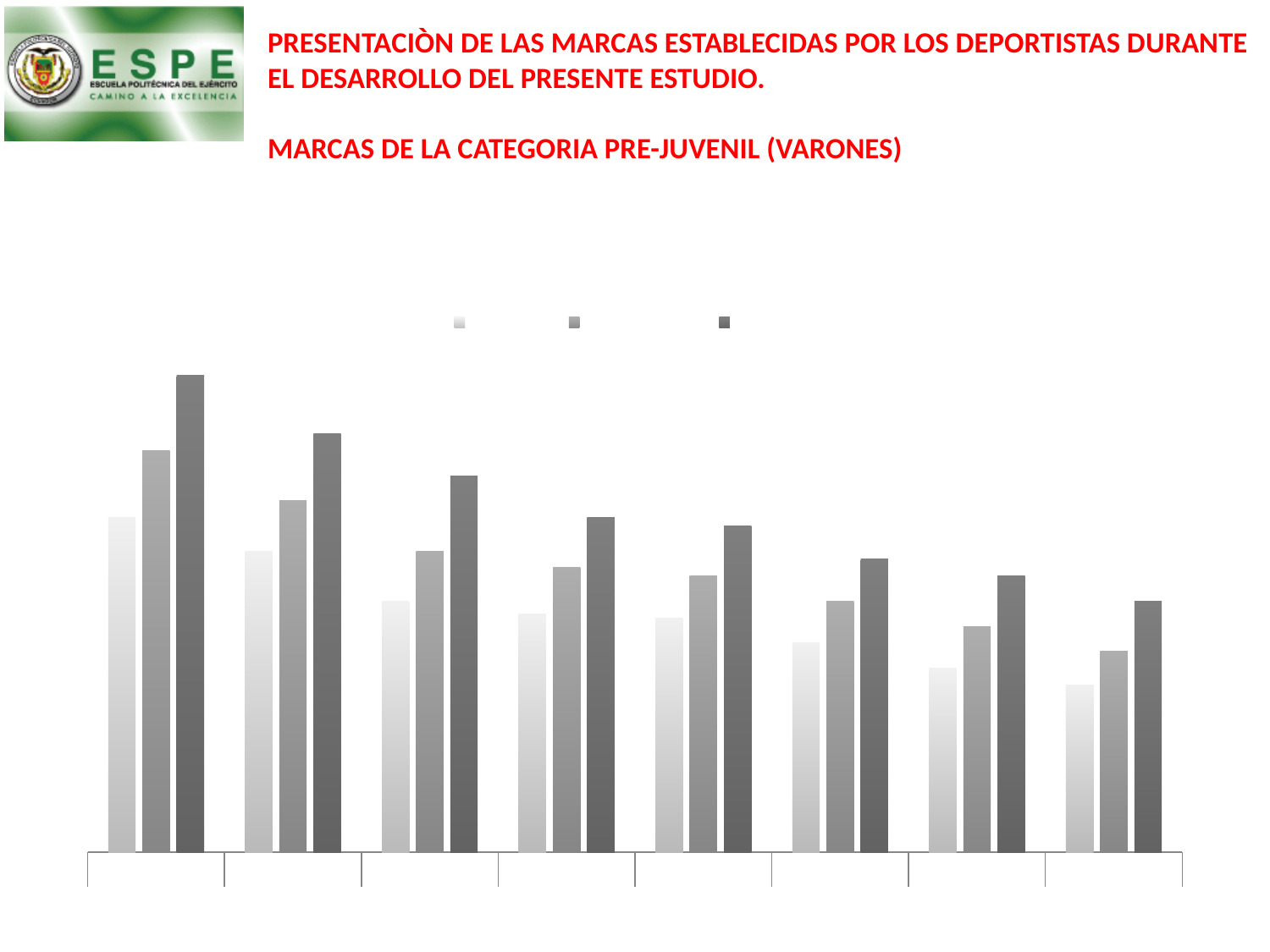
Counting from the left, which group of bars contains the tallest bar on the chart? the first group How many series does the legend list? 3 Is the darkest bar in the first group taller or shorter than the darkest bar in the second group? taller According to the slide text, which category's marks does the chart present? Pre-Juvenil (Varones) Do the values of the lightest series rise or fall from left to right along the x axis? fall Counting from the left, which group of bars contains the shortest bar on the chart? the eighth (rightmost) group How many groups of bars are plotted along the x axis? 8 What kind of chart is shown on the slide? bar chart Do the values of the darkest series rise or fall from left to right along the x axis? fall In what colours are the bars drawn? shades of grey Is the lightest bar in the third group taller or shorter than the lightest bar in the seventh group? taller In the leftmost group, which bar is tallest: the lightest, the medium grey, or the darkest? the darkest